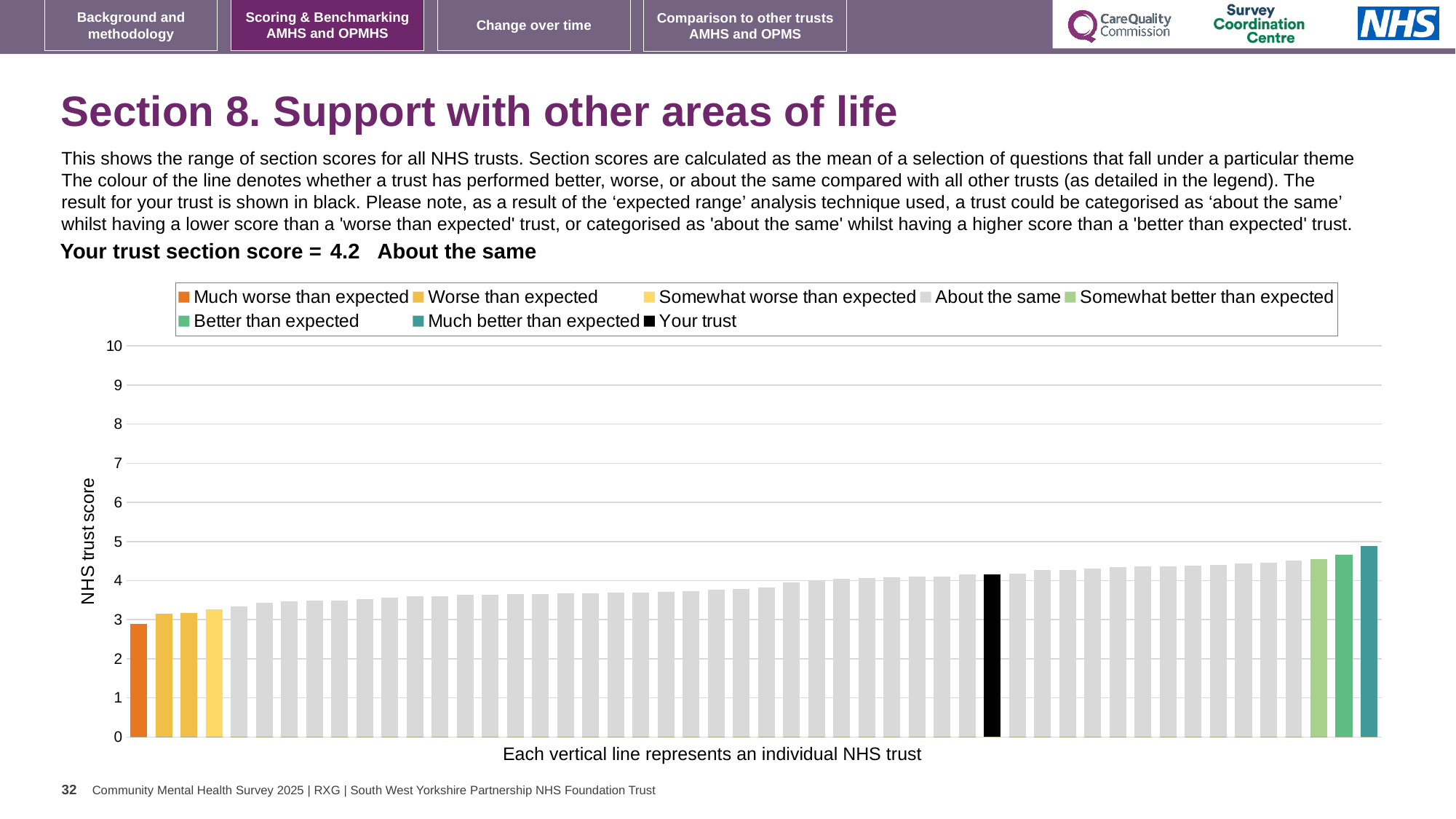
Which legend category does the highest bar belong to? Much better than expected Which category is your trust placed in according to the slide? About the same What is the section score for your trust shown on the slide? 4.2 Is the value of the black 'Your trust' bar greater or less than 4? greater How many entries does the chart legend list? 8 Do the bar values rise or fall from left to right along the x axis? rise What is the label on the vertical axis of the chart? NHS trust score What kind of chart is shown on the slide? bar chart Which legend category does the lowest bar belong to? Much worse than expected Which is larger: the 'Your trust' bar or the leftmost orange bar? Your trust Is the value of the leftmost (orange) bar greater or less than 4? less Is the value of the rightmost (teal) bar greater or less than 4? greater